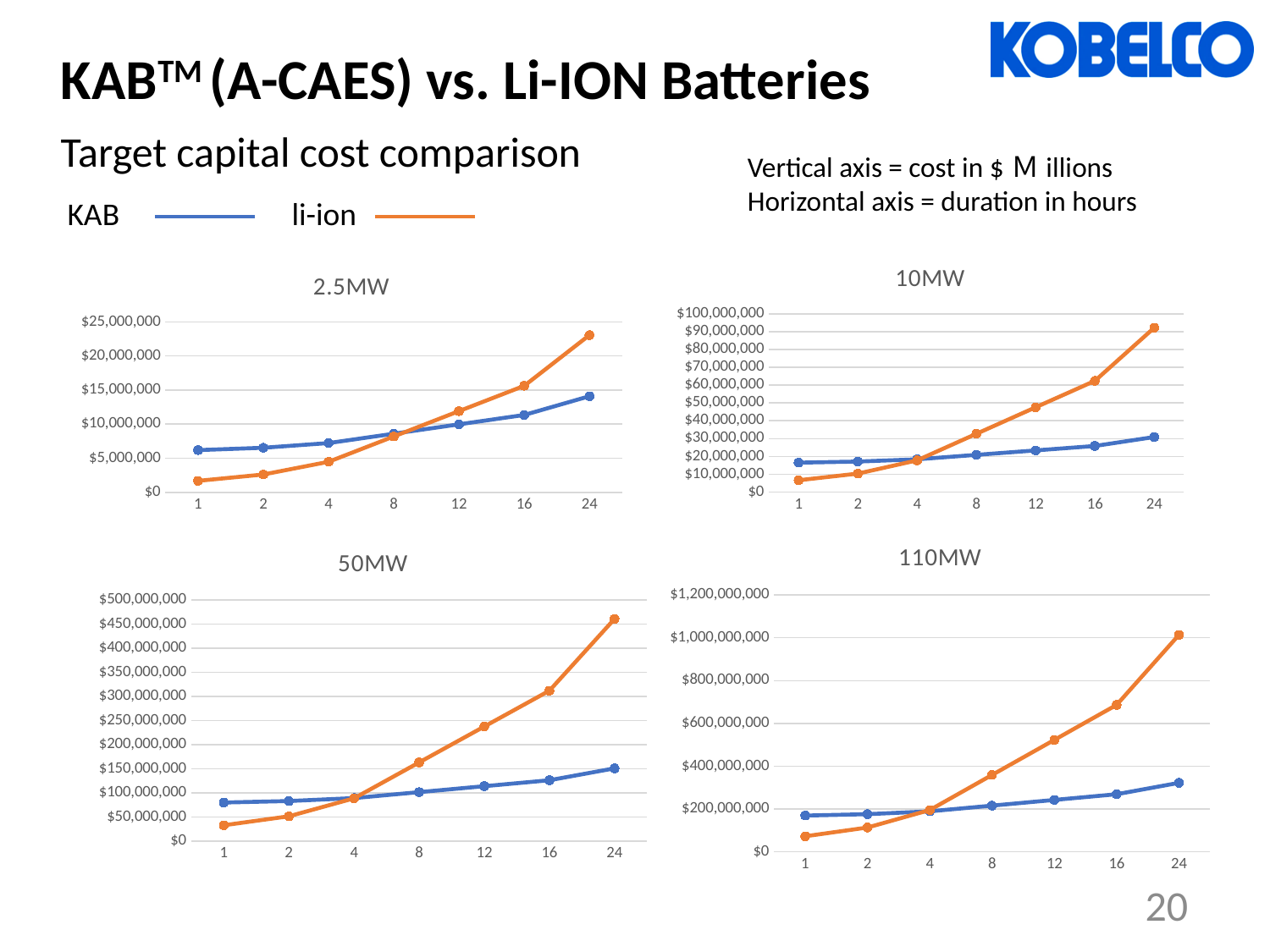
How many series does the legend list? 2 In the 50MW chart, which series has the higher value at 24 hours, KAB or li-ion? li-ion In the 110MW chart, which series has the higher value at 1 hour, KAB or li-ion? KAB In the 10MW chart, is the li-ion value at 24 hours greater or less than $80,000,000? greater In the 110MW chart, is the li-ion value at 24 hours greater or less than $800,000,000? greater In the 110MW chart, does the li-ion line rise or fall as duration increases? rises In the 2.5MW chart, is the li-ion value at 24 hours greater or less than $20,000,000? greater In the 10MW chart, at which duration is the li-ion value highest? 24 In the 10MW chart, how many duration points are plotted along the x axis? 7 What kind of chart is the 2.5MW chart? line chart What colour is the li-ion line in the charts? orange